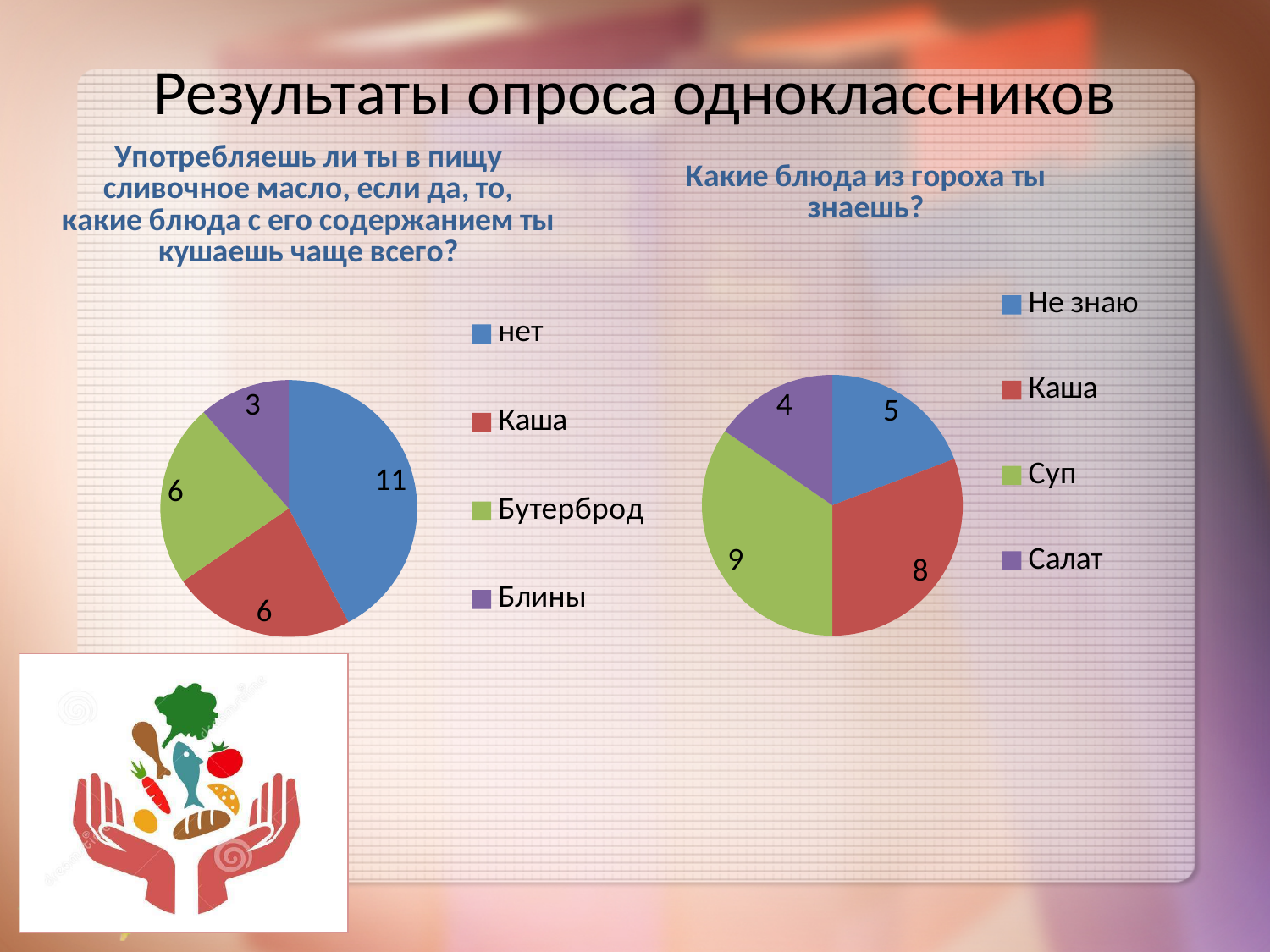
How many categories does the legend of the right pie chart (about pea dishes) list? 4 In the right pie chart (about pea dishes), which is larger: "Каша" or "Суп"? Суп In the left pie chart (about butter dishes), which category has the largest slice? нет In the right pie chart (about pea dishes), what is the difference between "Суп" and "Салат"? 5 In the left pie chart (about butter dishes), how many respondents answered "нет"? 11 In the right pie chart (about pea dishes), what is the value for "Не знаю"? 5 In the left pie chart (about butter dishes), what colour is the "Бутерброд" slice? Green In the right pie chart (about pea dishes), what is the value for "Суп"? 9 In the right pie chart (about pea dishes), which category has the smallest slice? Салат In the left pie chart (about butter dishes), which category has the smallest slice? Блины What type of chart is used on the left side of the slide? Pie chart In the left pie chart (about butter dishes), what is the difference between "нет" and "Блины"? 8